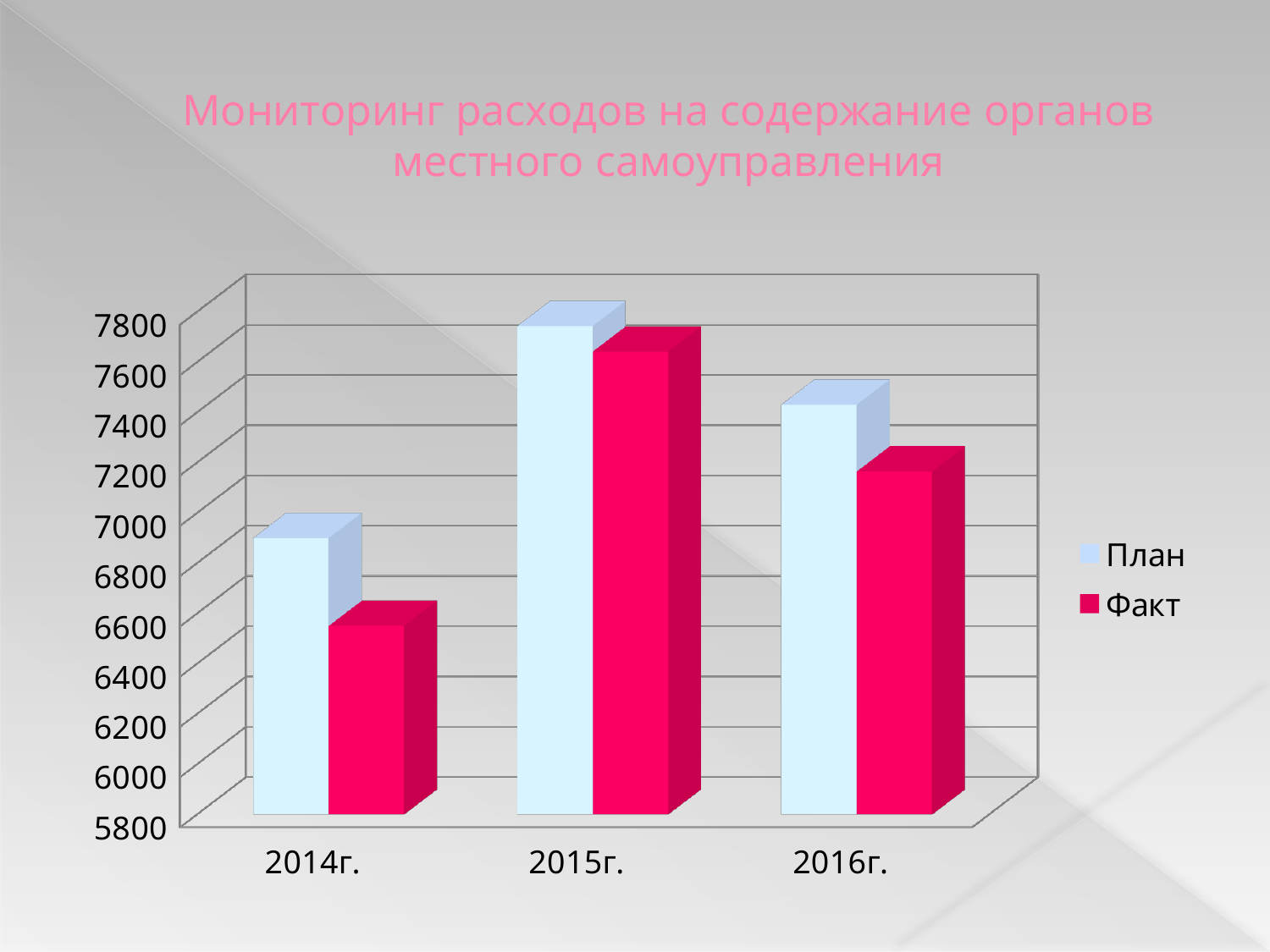
How many years (categories) are shown on the x axis? 3 Is the Факт value for 2016г. greater or less than 7400? less Which series are listed in the legend? План and Факт How many series does the legend list? 2 Does the План value rise or fall from 2015г. to 2016г.? fall Is the План value for 2015г. greater or less than 7600? greater What colour are the Факт bars? red (pink-red) In which year is the Факт value lowest? 2014г. Is the Факт value for 2014г. greater or less than 6800? less What kind of chart is shown on the slide? bar chart In 2014г., which is larger, План or Факт? План In which year is the План value highest? 2015г.